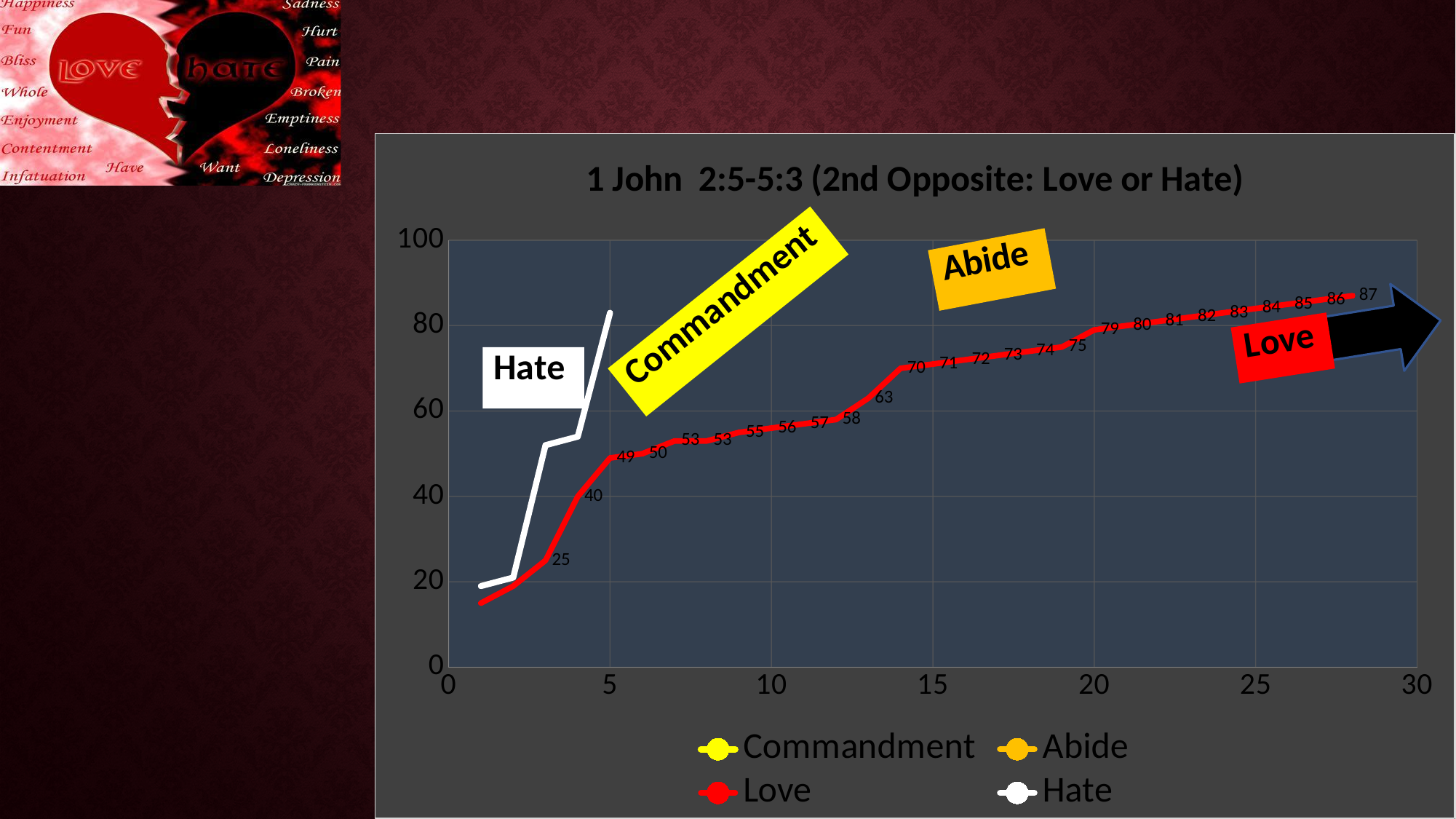
Does the Love line rise or fall as the x axis increases? rises Is the value of the Love line at x = 20 greater or less than 60? greater What is the lowest data label shown on the Love line? 25 How many series does the chart legend list? 4 Is the value of the Hate line at x = 5 greater or less than 60? greater What is the maximum value shown on the vertical axis? 100 What is the highest data label shown on the Love line? 87 At x = 5, which line is higher, the Love line or the Hate line? Hate What is the difference between the highest and lowest data labels on the Love line (87 and 25)? 62 What kind of chart is shown on the slide? line chart What is the title of the chart? 1 John 2:5-5:3 (2nd Opposite: Love or Hate) What colour is the Love series line? red